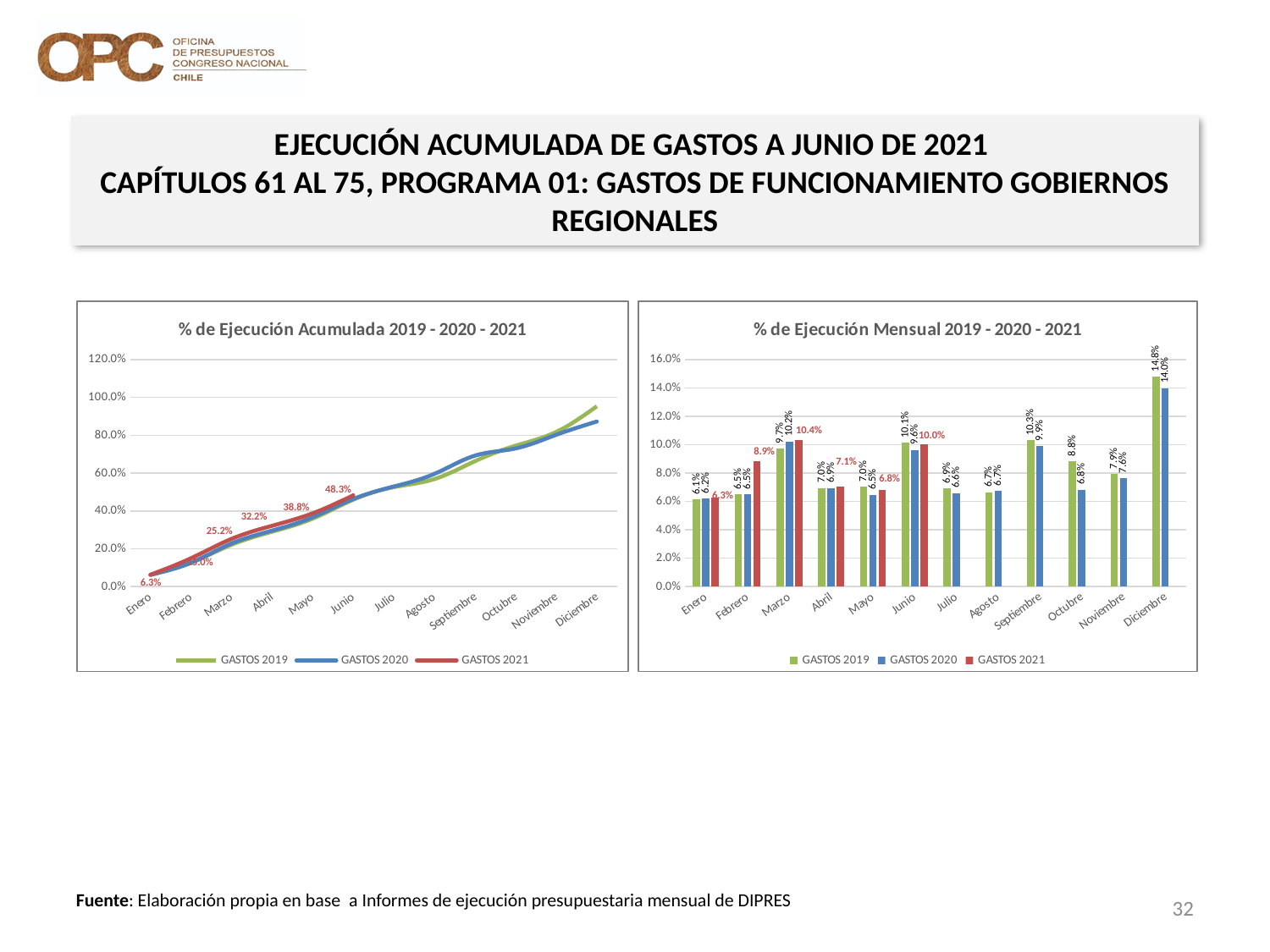
In the left chart (% de Ejecución Acumulada 2019 - 2020 - 2021), what is the difference between the GASTOS 2021 values for Junio and Mayo? 9.5 percentage points What kind of chart is the right chart, % de Ejecución Mensual 2019 - 2020 - 2021? Bar chart In the left chart (% de Ejecución Acumulada 2019 - 2020 - 2021), what is the value for GASTOS 2021 in Junio? 48.3% In the right chart (% de Ejecución Mensual 2019 - 2020 - 2021), what is the difference between GASTOS 2021 and GASTOS 2020 in Febrero? 2.4 percentage points In the right chart (% de Ejecución Mensual 2019 - 2020 - 2021), which month has the highest value for GASTOS 2020? Diciembre How many series does the legend of the left chart (% de Ejecución Acumulada 2019 - 2020 - 2021) list? 3 In the right chart (% de Ejecución Mensual 2019 - 2020 - 2021), which is larger in Octubre: GASTOS 2019 or GASTOS 2020? GASTOS 2019 In the left chart (% de Ejecución Acumulada 2019 - 2020 - 2021), do the values rise or fall from Enero to Diciembre? Rise What kind of chart is the left chart, % de Ejecución Acumulada 2019 - 2020 - 2021? Line chart In the left chart (% de Ejecución Acumulada 2019 - 2020 - 2021), what is the value for GASTOS 2021 in Marzo? 25.2% In the right chart (% de Ejecución Mensual 2019 - 2020 - 2021), what is the value for GASTOS 2021 in Febrero? 8.9% In the right chart (% de Ejecución Mensual 2019 - 2020 - 2021), what is the value for GASTOS 2019 in Diciembre? 14.8%